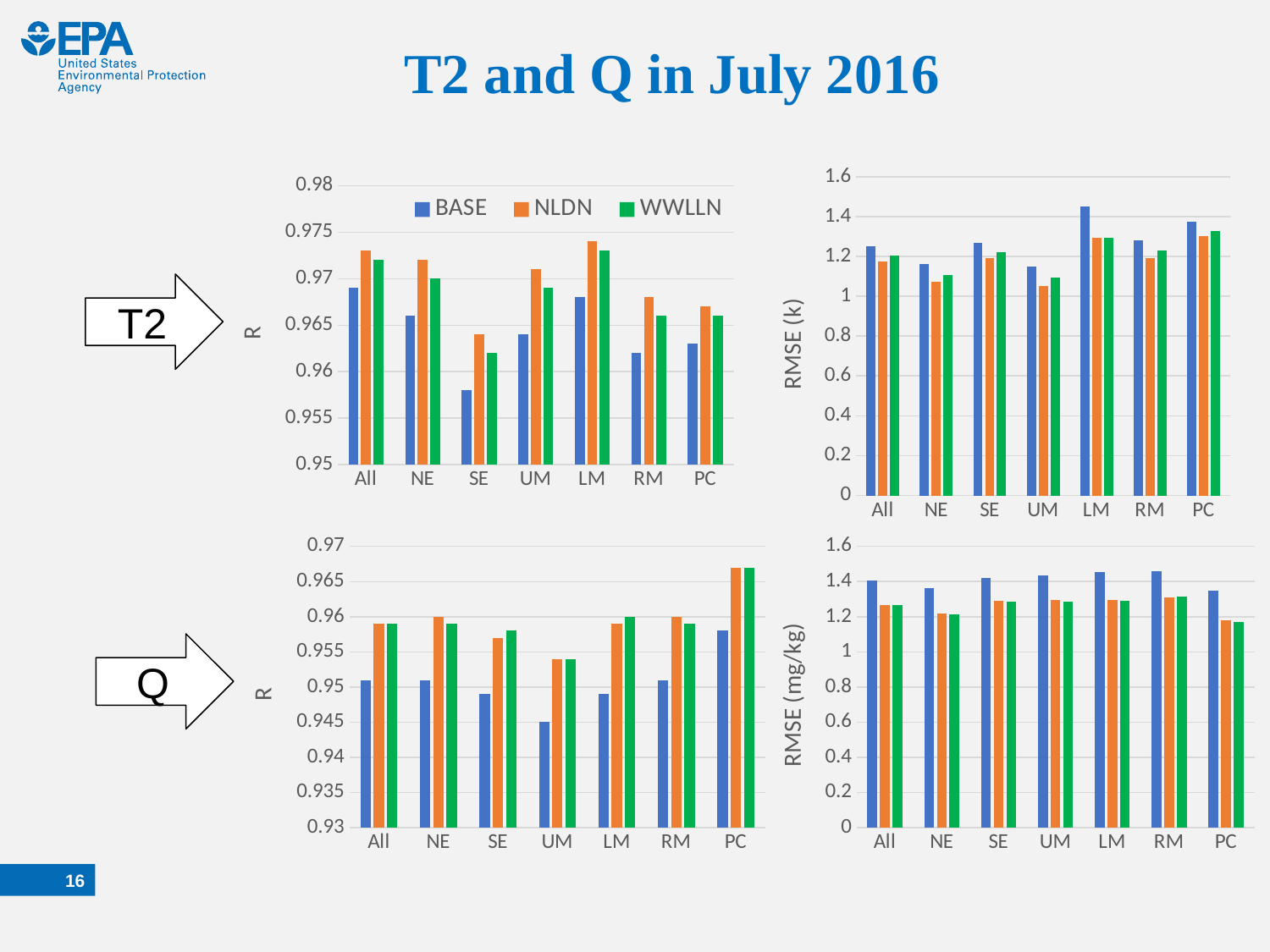
In the top-left chart (T2, R), how many categories are shown on the x axis? 7 What is the y-axis label of the bottom-right chart? RMSE (mg/kg) In the top-right chart (T2, RMSE (k)), which category has the highest BASE value? LM In the bottom-left chart (Q, R), which category has the lowest BASE value? UM In the bottom-right chart (Q, RMSE (mg/kg)), for PC, which is larger: BASE or NLDN? BASE In the top-left chart (T2, R), which category has the lowest BASE value? SE In the bottom-left chart (Q, R), is the NLDN value for PC greater or less than 0.965? greater In the top-right chart (T2, RMSE (k)), is the NLDN value for UM greater or less than 1.2? less In the top-left chart (T2, R), is the BASE value for SE greater or less than 0.96? less In the top-left chart (T2, R), how many series does the legend list? 3 In the top-left chart (T2, R), for SE, which is larger: BASE or NLDN? NLDN What kind of chart is the top-right chart (T2, RMSE (k))? bar chart